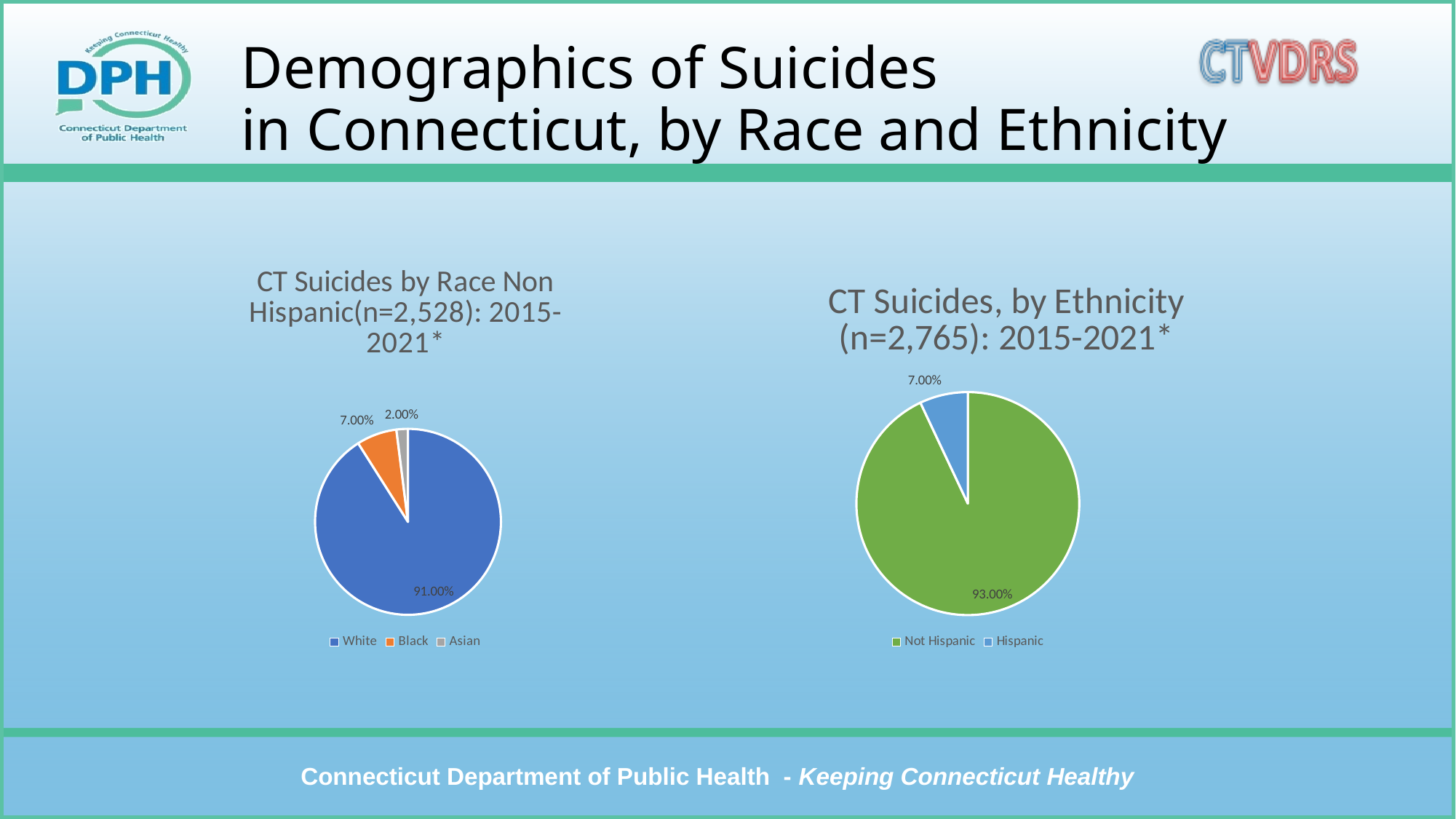
In the left pie chart (CT Suicides by Race Non Hispanic), what percentage is shown for Black? 7.00% In the left pie chart (CT Suicides by Race Non Hispanic), what is the difference in percentage points between Black and Asian? 5.00% In the right pie chart (CT Suicides, by Ethnicity), what is the difference in percentage points between Not Hispanic and Hispanic? 86.00% How many categories does the legend of the left pie chart (CT Suicides by Race Non Hispanic) list? 3 In the left pie chart (CT Suicides by Race Non Hispanic), which category has the smallest slice? Asian In the right pie chart (CT Suicides, by Ethnicity), what percentage is shown for Hispanic? 7.00% In the right pie chart (CT Suicides, by Ethnicity), what percentage is shown for Not Hispanic? 93.00% What type of chart is used for CT Suicides, by Ethnicity? Pie chart In the left pie chart (CT Suicides by Race Non Hispanic), what percentage is shown for Asian? 2.00% In the right pie chart (CT Suicides, by Ethnicity), what is the sample size (n) given in the title? 2,765 In the left pie chart (CT Suicides by Race Non Hispanic), what percentage is shown for White? 91.00% In the left pie chart (CT Suicides by Race Non Hispanic), which category has the largest slice? White